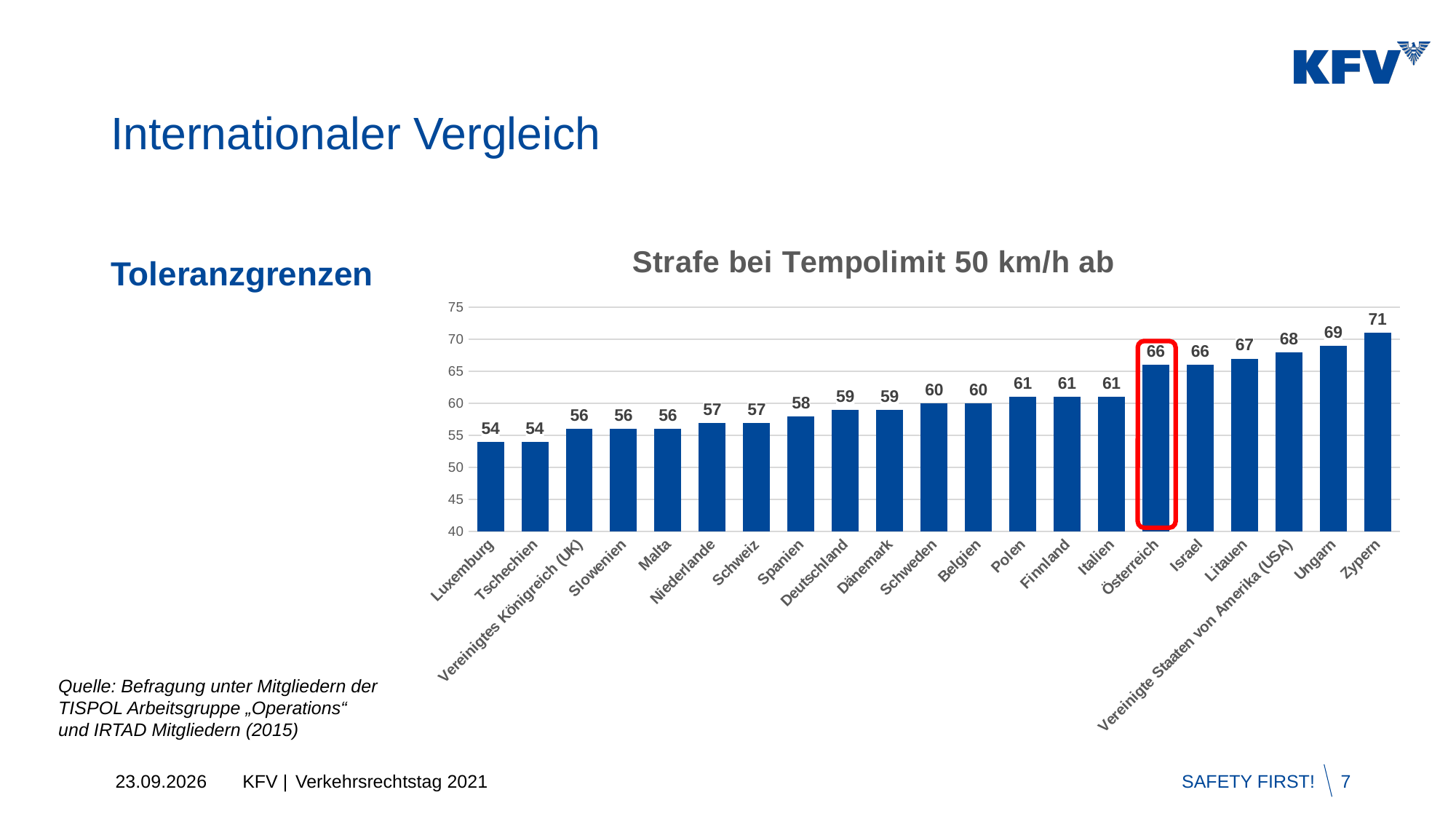
What kind of chart is shown on the slide? Bar chart Which has a larger value, Polen or Malta? Polen What is the value for Deutschland in the chart? 59 What is the difference between the values for Ungarn and Österreich? 3 Is the value for Litauen greater or less than 65? greater How many countries are shown in the chart? 21 What is the title of the chart? Strafe bei Tempolimit 50 km/h ab What is the difference between the values for Zypern and Luxemburg? 17 What is the value for Österreich in the chart? 66 What is the lowest value shown in the chart? 54 Which country has the highest value in the chart? Zypern What is the value for Zypern in the chart? 71